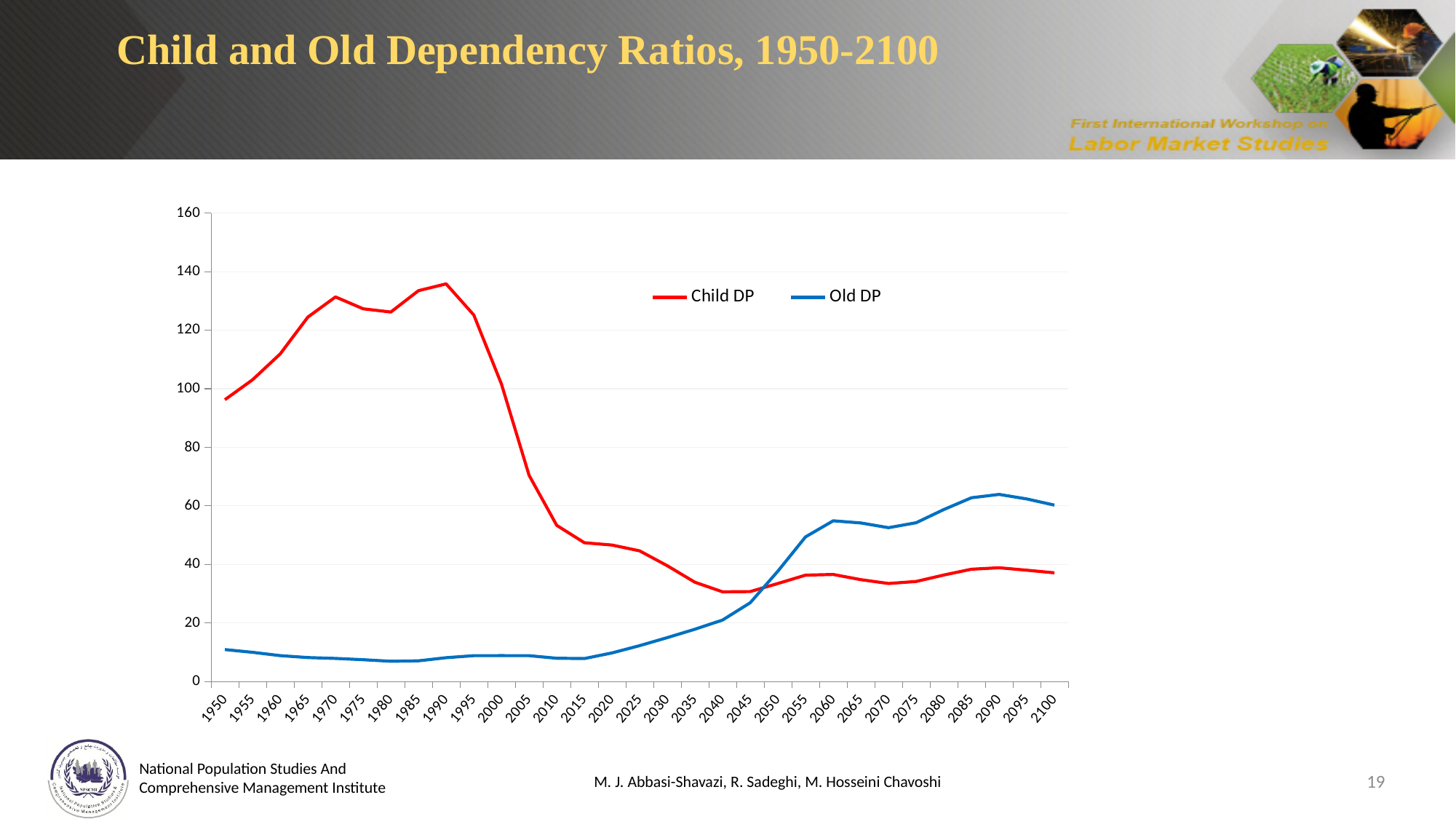
How many years are marked along the x axis? 31 Which series has the larger value in 1970, Child DP or Old DP? Child DP What kind of chart is shown on the slide? line chart What colour is the line for Old DP? blue Is the Old DP value for 2060 greater or less than 40? greater Is the Old DP value for 1950 greater or less than 20? less In which year does the Child DP series reach its highest value? 1990 How many series does the legend list? 2 Is the Child DP value for 1990 greater or less than 120? greater Does the Child DP series rise or fall between 1995 and 2040? fall Which series has the larger value in 2100, Child DP or Old DP? Old DP